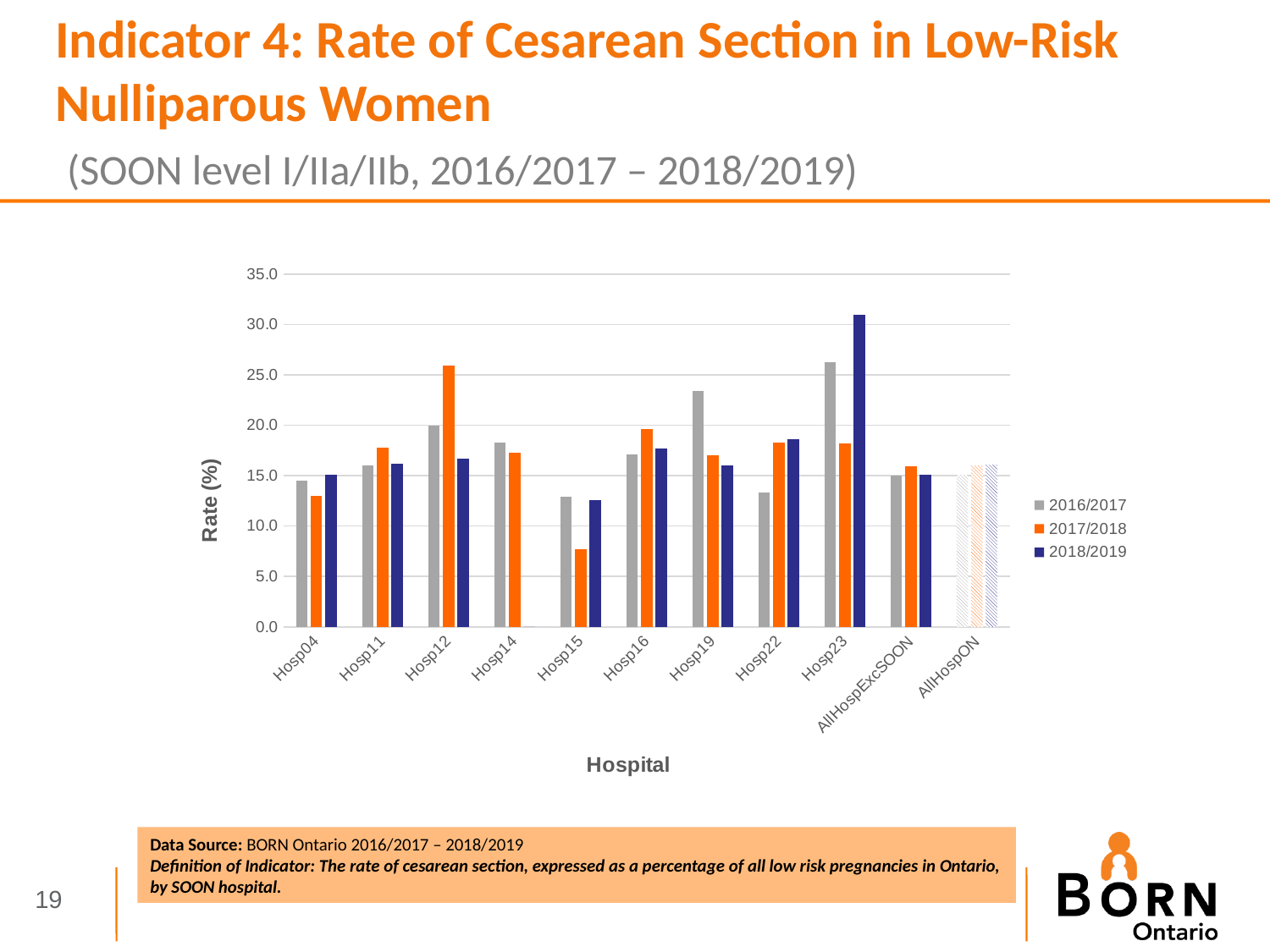
Is the 2018/2019 value for Hosp23 greater or less than 30.0? greater Which hospital has the highest 2017/2018 rate? Hosp12 For Hosp12, which is larger: the 2017/2018 value or the 2018/2019 value? 2017/2018 What is the title of the y axis? Rate (%) How many series does the legend list? 3 Is the 2016/2017 value for Hosp19 greater or less than 20.0? greater Which hospital has the highest 2018/2019 rate? Hosp23 Which hospital has the lowest 2017/2018 rate? Hosp15 Do the values for Hosp19 rise or fall from 2016/2017 to 2018/2019? fall What kind of chart is shown on the slide? bar chart Is the 2017/2018 value for Hosp15 greater or less than 10.0? less How many hospital categories are shown on the x axis? 11